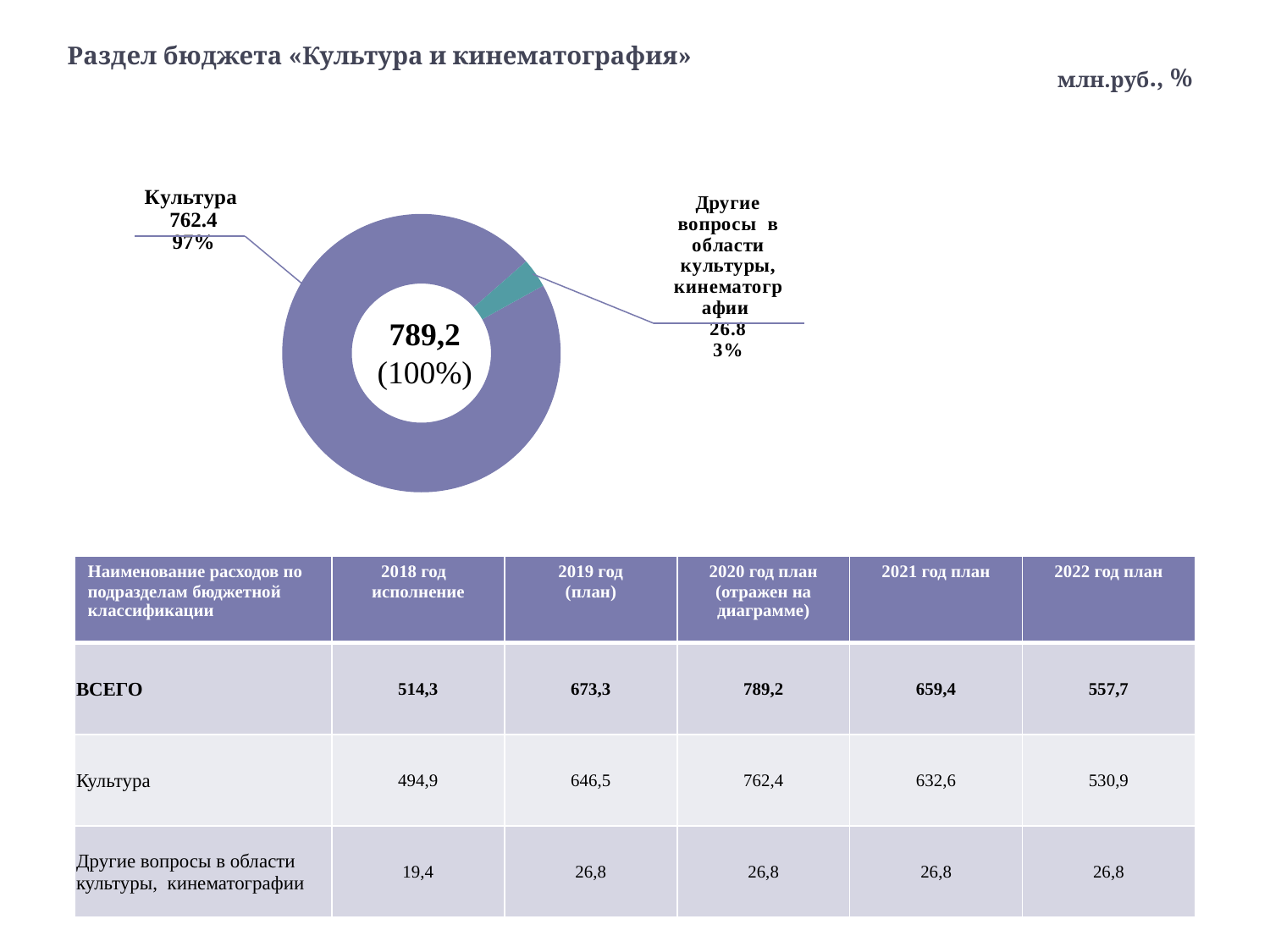
What is the value shown for the "Другие вопросы в области культуры, кинематографии" slice in the doughnut chart? 26.8 What kind of chart is shown on the slide? Doughnut (pie) chart Which is larger in the doughnut chart: the "Культура" slice or the "Другие вопросы в области культуры, кинематографии" slice? Культура How many slices does the doughnut chart have? 2 What is the value shown for the "Культура" slice in the doughnut chart? 762.4 Which slice of the doughnut chart is the smallest? Другие вопросы в области культуры, кинематографии Which slice of the doughnut chart is the largest? Культура What is the difference between the "Культура" value and the "Другие вопросы в области культуры, кинематографии" value in the doughnut chart? 735.6 What units are indicated for the chart on the slide? млн.руб., % What share of the doughnut chart does the "Другие вопросы в области культуры, кинематографии" slice represent? 3% What total value is shown in the centre of the doughnut chart? 789,2 (100%) What share of the doughnut chart does the "Культура" slice represent? 97%